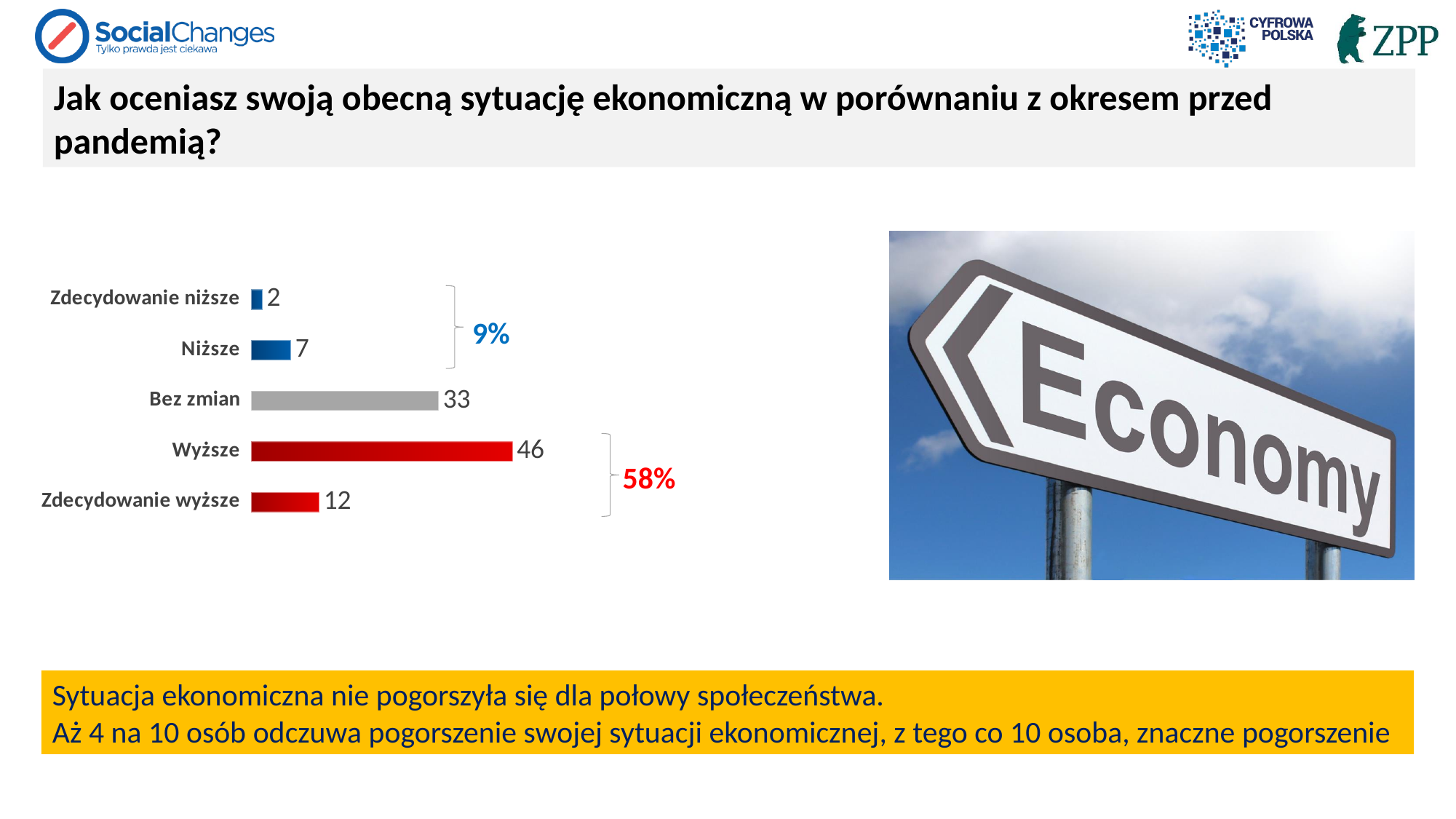
What combined percentage is shown next to the bracket grouping "Wyższe" and "Zdecydowanie wyższe"? 58% Which category has the highest value? Wyższe What is the value for "Zdecydowanie wyższe"? 12 Which is larger, the value for "Zdecydowanie wyższe" or the value for "Niższe"? Zdecydowanie wyższe Which category has the lowest value? Zdecydowanie niższe What is the value for "Zdecydowanie niższe"? 2 What is the value for "Bez zmian"? 33 How many categories does the chart show? 5 What kind of chart is shown on the slide? bar chart What is the difference between the values for "Wyższe" and "Bez zmian"? 13 What is the value for "Niższe"? 7 What is the value for "Wyższe"? 46